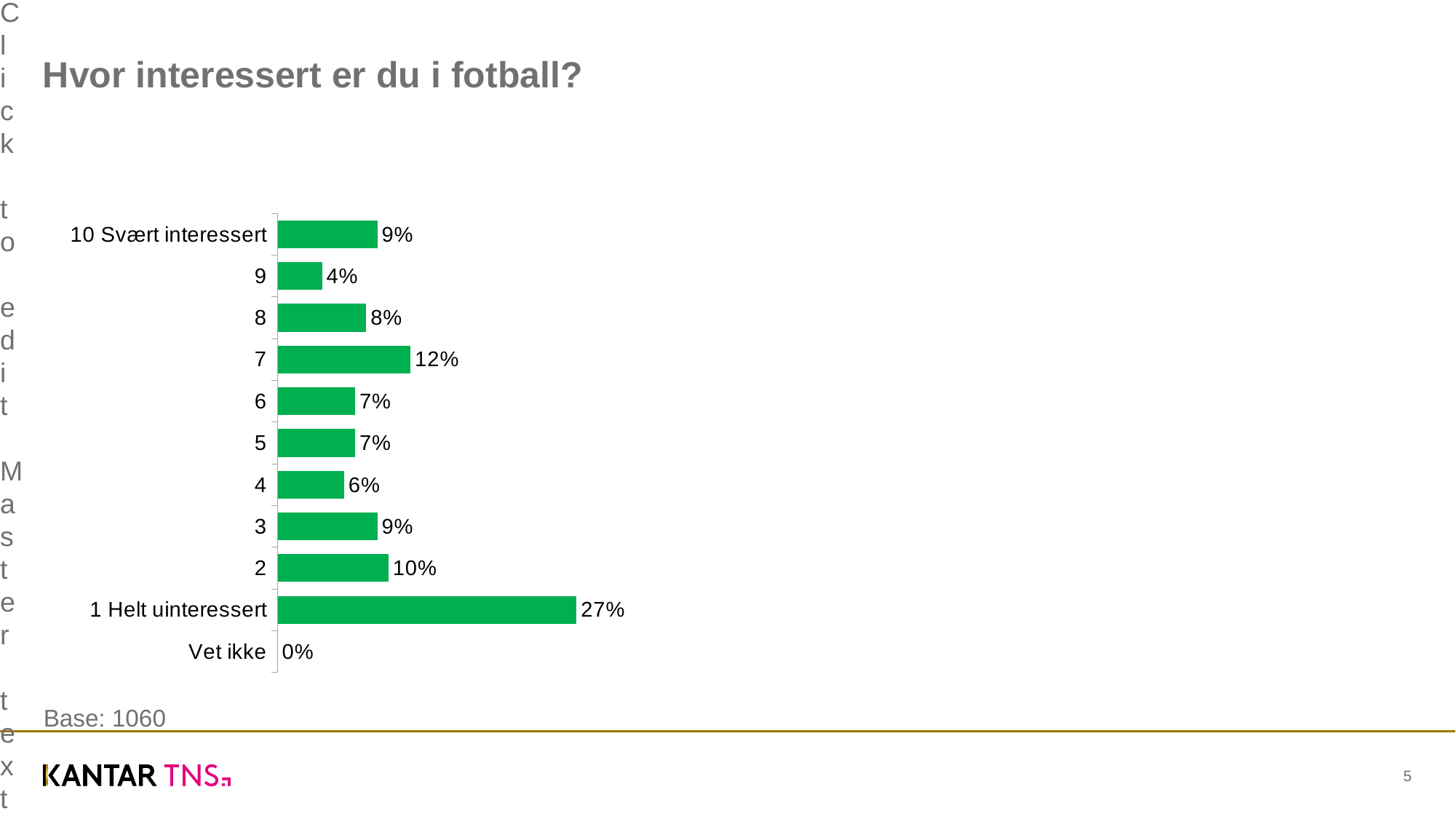
Which category has the lowest value? Vet ikke What is the value for "1 Helt uinteressert"? 27% What is the value for "Vet ikke"? 0% How many categories are shown on the chart? 11 What is the base (number of respondents) stated on the slide? 1060 What is the value for category 7? 12% Which is larger, the value for category 7 or the value for category 9? 7 What is the value for "10 Svært interessert"? 9% What is the title of the slide? Hvor interessert er du i fotball? Which category has the highest value? 1 Helt uinteressert What kind of chart is shown on the slide? Bar chart What is the difference between the values for "1 Helt uinteressert" and "10 Svært interessert"? 18%